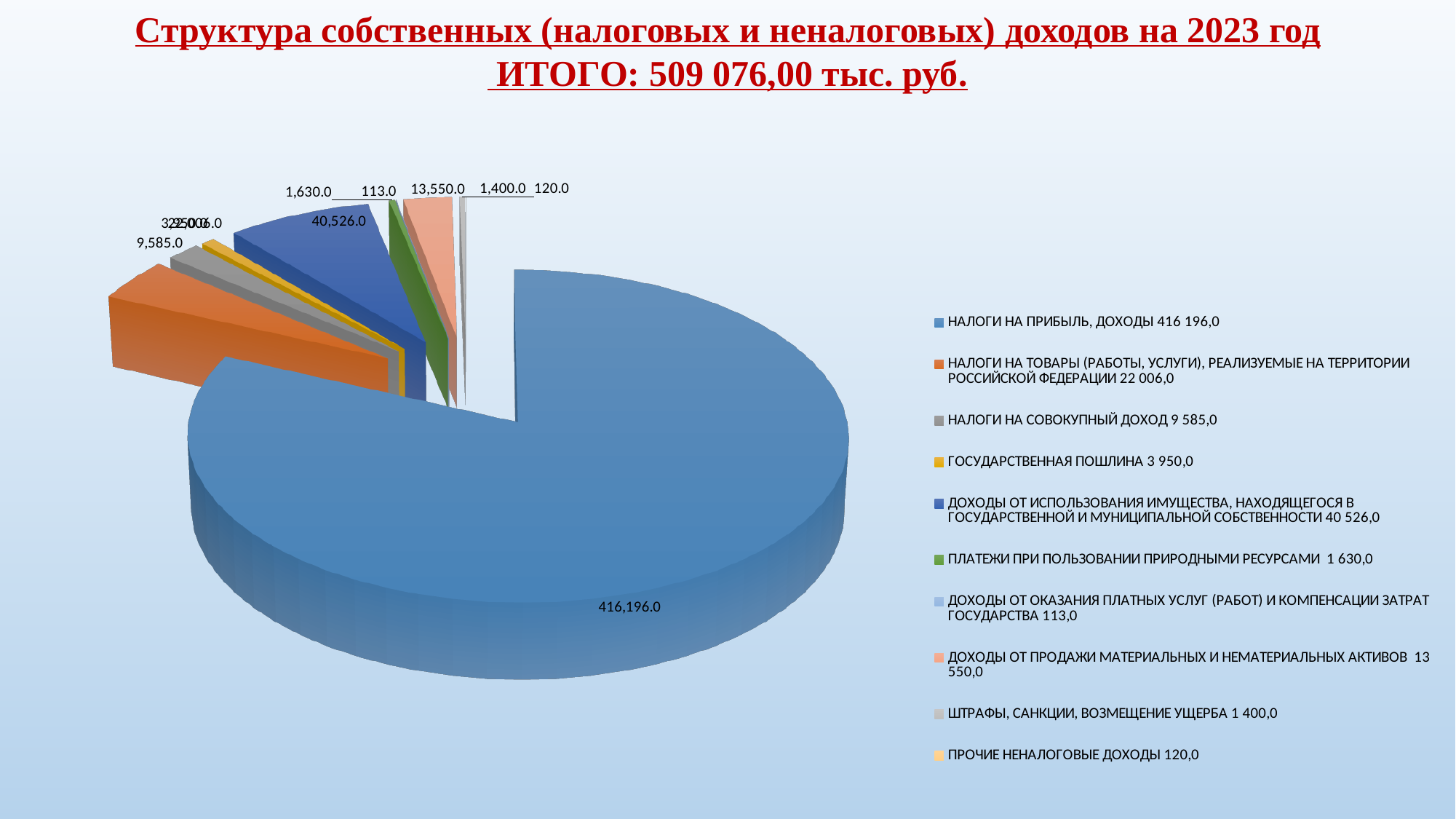
What is the value of the slice for ДОХОДЫ ОТ ПРОДАЖИ МАТЕРИАЛЬНЫХ И НЕМАТЕРИАЛЬНЫХ АКТИВОВ? 13,550.0 Which category has the smallest slice of the pie? ДОХОДЫ ОТ ОКАЗАНИЯ ПЛАТНЫХ УСЛУГ (РАБОТ) И КОМПЕНСАЦИИ ЗАТРАТ ГОСУДАРСТВА What value does the legend give for ГОСУДАРСТВЕННАЯ ПОШЛИНА? 3 950,0 What is the difference between the values for НАЛОГИ НА ПРИБЫЛЬ, ДОХОДЫ and ДОХОДЫ ОТ ИСПОЛЬЗОВАНИЯ ИМУЩЕСТВА, НАХОДЯЩЕГОСЯ В ГОСУДАРСТВЕННОЙ И МУНИЦИПАЛЬНОЙ СОБСТВЕННОСТИ? 375,670.0 What total amount is stated in the chart title (ИТОГО)? 509 076,00 тыс. руб. How many slices does the pie chart have? 10 What is the value of the slice for ДОХОДЫ ОТ ИСПОЛЬЗОВАНИЯ ИМУЩЕСТВА, НАХОДЯЩЕГОСЯ В ГОСУДАРСТВЕННОЙ И МУНИЦИПАЛЬНОЙ СОБСТВЕННОСТИ? 40,526.0 What is the value of the slice for НАЛОГИ НА ПРИБЫЛЬ, ДОХОДЫ? 416,196.0 Which is larger: the value for ПЛАТЕЖИ ПРИ ПОЛЬЗОВАНИИ ПРИРОДНЫМИ РЕСУРСАМИ or the value for ШТРАФЫ, САНКЦИИ, ВОЗМЕЩЕНИЕ УЩЕРБА? ПЛАТЕЖИ ПРИ ПОЛЬЗОВАНИИ ПРИРОДНЫМИ РЕСУРСАМИ What is the value of the slice for НАЛОГИ НА СОВОКУПНЫЙ ДОХОД? 9,585.0 Which category has the largest slice of the pie? НАЛОГИ НА ПРИБЫЛЬ, ДОХОДЫ What type of chart is shown on the slide? Pie chart